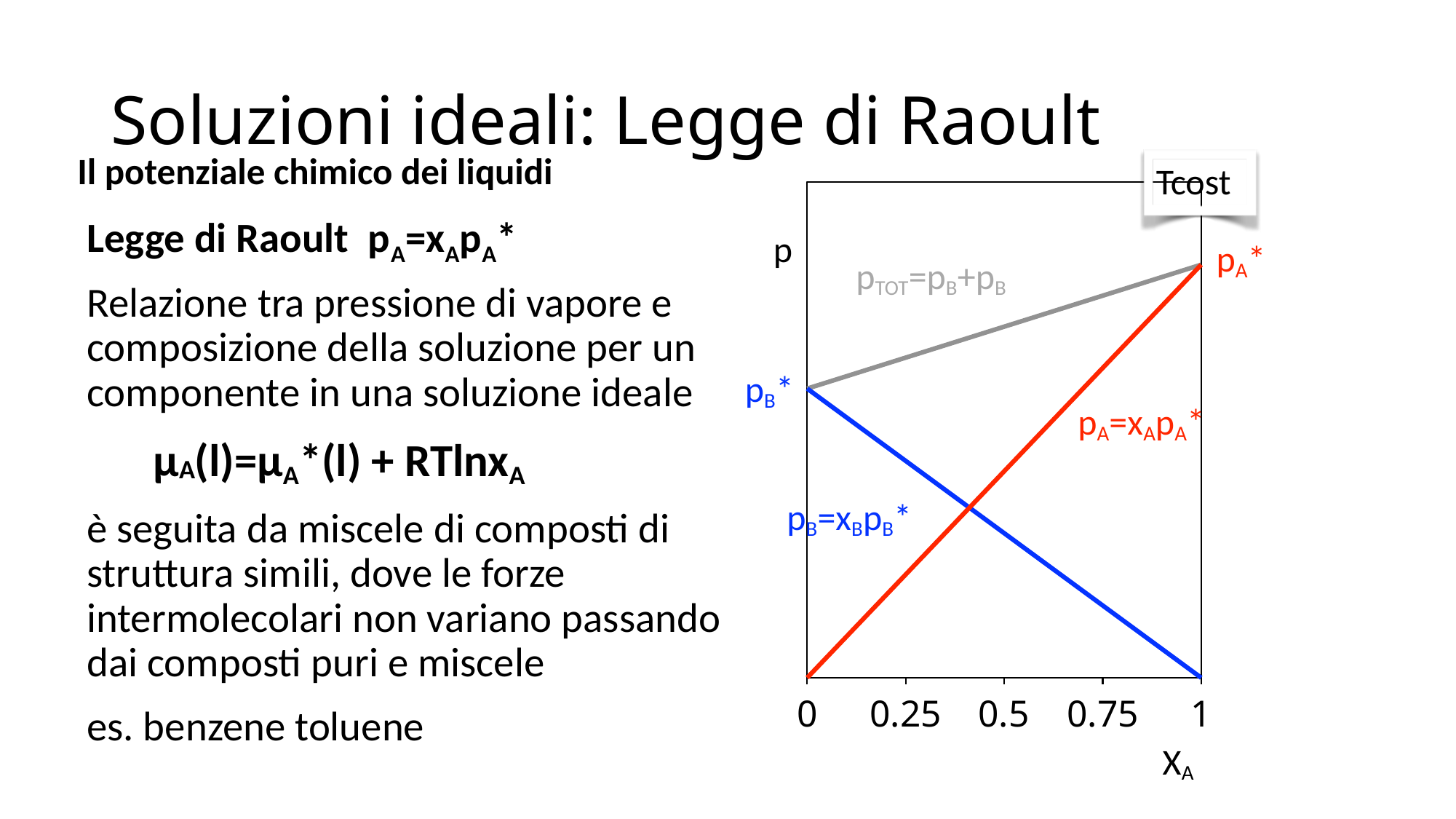
What kind of chart is shown on the right of the slide? line chart At x_A = 0.75, which line is higher, the red line or the blue line? red line Which is larger, p_A* or p_B*? p_A* What is the label of the y axis of the chart? p How many tick labels are shown on the x axis of the chart? 5 Does the blue line (p_B = x_B p_B*) rise or fall as x_A increases from 0 to 1? falls What is the label of the x axis of the chart? x_A Does the gray line (p_TOT) rise or fall as x_A increases from 0 to 1? rises Is the x_A value at which the red and blue lines cross greater or less than 0.5? less How many lines are plotted in the chart? 3 Does the red line (p_A = x_A p_A*) rise or fall as x_A increases from 0 to 1? rises At x_A = 0.25, which line is higher, the red line or the blue line? blue line